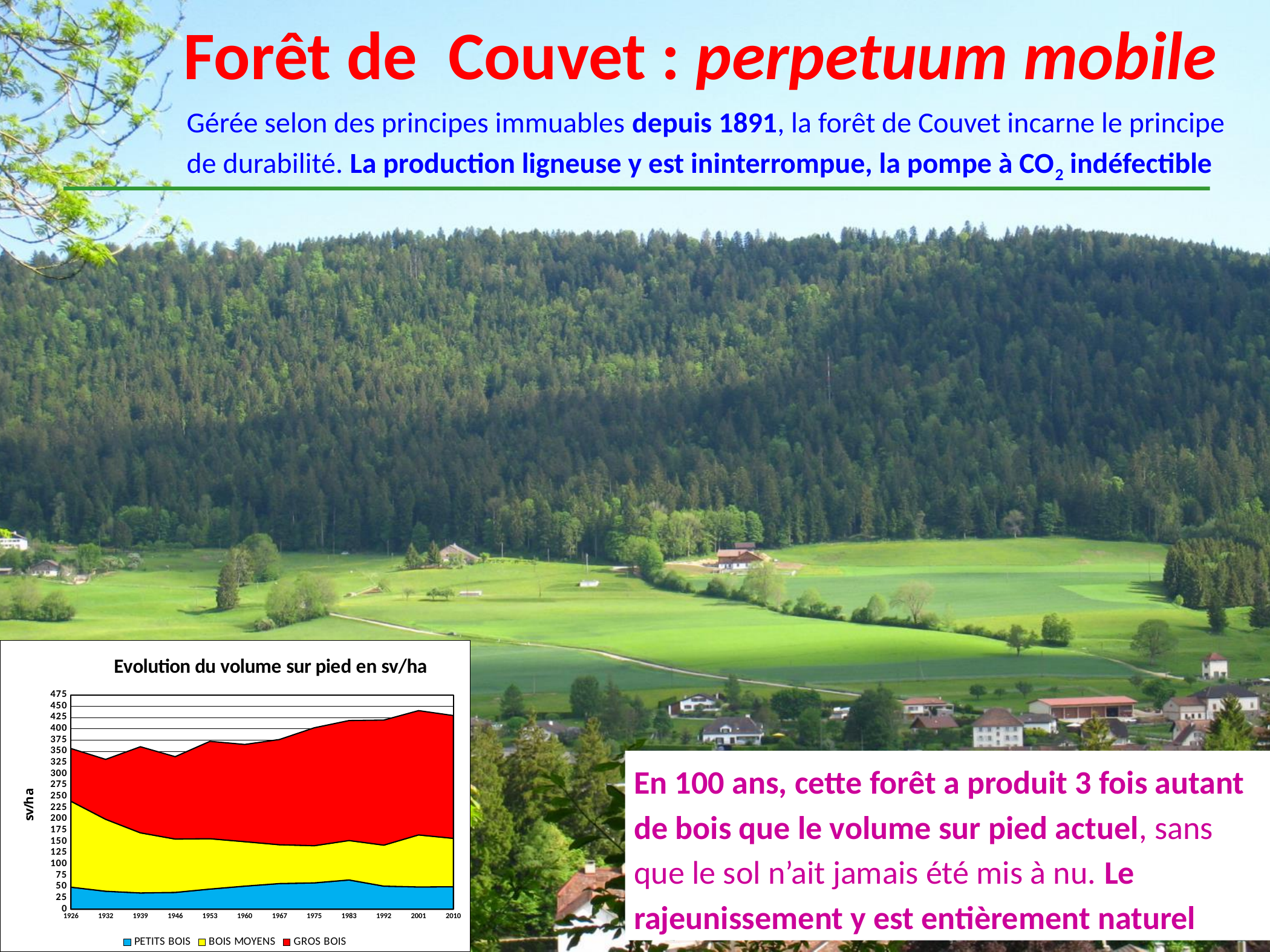
Which is larger, the total volume sur pied in 2010 or in 1926? 2010 Is the total volume sur pied in 2010 greater or less than 400 sv/ha? greater Does the BOIS MOYENS band get thicker or thinner between 1926 and 1960? thinner Does the total volume sur pied rise or fall overall between 1926 and 2010? rise How many years are marked along the x axis of the chart? 12 What kind of chart is shown on the slide? stacked area chart Is the total volume sur pied in 1946 greater or less than 375 sv/ha? less Which series is shown in red in the chart? GROS BOIS Is the value for PETITS BOIS in 1983 greater or less than 50 sv/ha? greater What is the title of the chart? Evolution du volume sur pied en sv/ha How many series does the chart legend list? 3